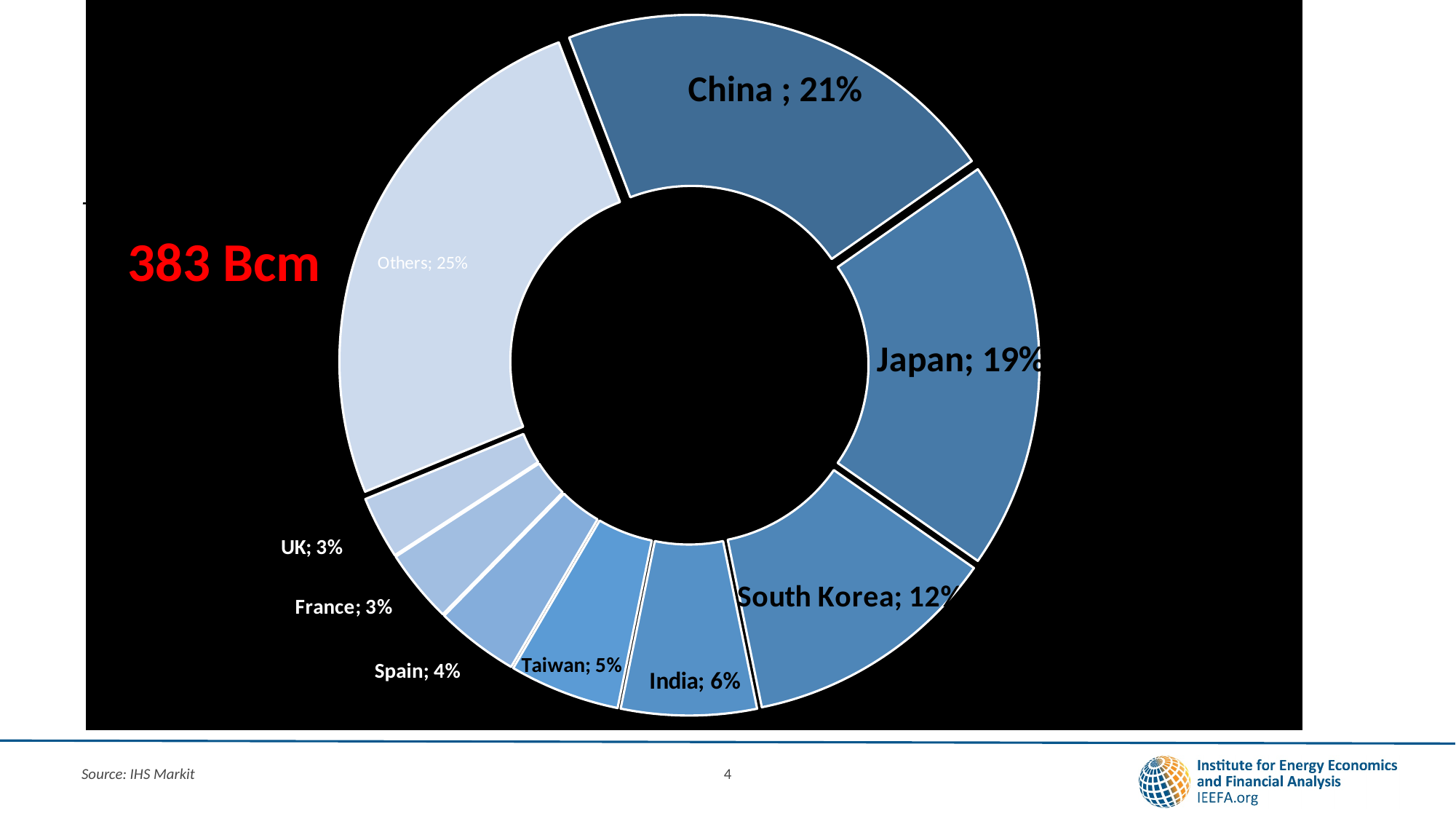
Which slice of the chart is the largest? Others Which has the larger share, Japan or South Korea? Japan What kind of chart is shown on the slide? Pie (doughnut) chart How many slices does the chart have? 9 What share is labelled for India? 6% What percentage is shown for Japan? 19% What is the value shown for South Korea? 12% What is the value shown for Spain? 4% What share of the chart does China account for? 21% What percentage is shown for Taiwan? 5% What is the difference in percentage points between China's share and Japan's share? 2% Which named country has the largest share in the chart? China